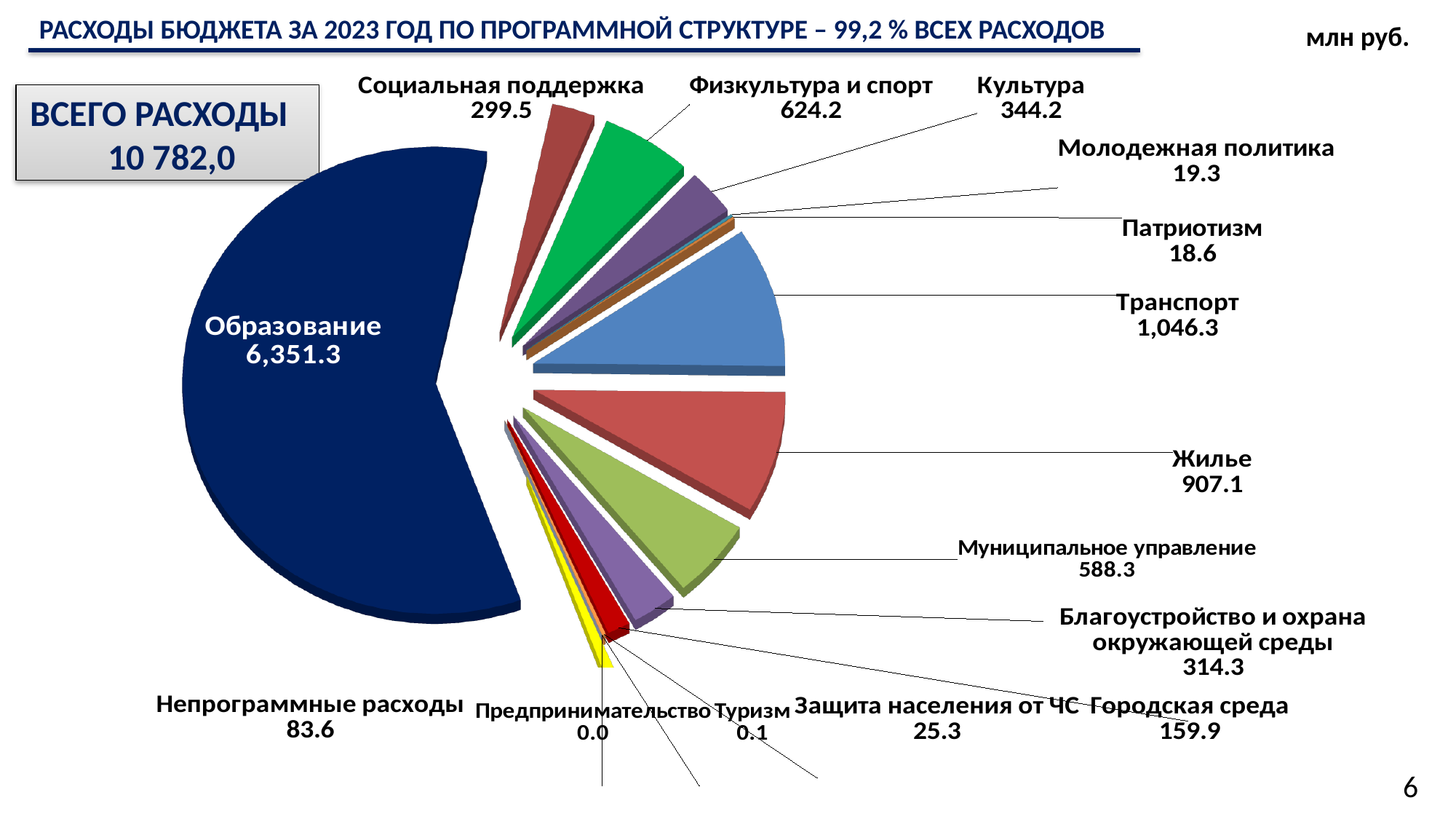
Which category has the largest slice in the pie chart? Образование What type of chart is shown on the slide? Pie chart What is the difference between the values for Физкультура и спорт and Культура? 280.0 What is the value for Образование in the pie chart? 6,351.3 What is the difference between the values for Транспорт and Жилье? 139.2 What is the value for Транспорт in the pie chart? 1,046.3 What is the value for Благоустройство и охрана окружающей среды? 314.3 Which is larger, Муниципальное управление or Социальная поддержка? Муниципальное управление What unit of measurement is indicated for the chart values? млн руб. What total expenditure is shown in the box on the slide (ВСЕГО РАСХОДЫ)? 10 782,0 How many categories are shown in the pie chart? 15 Which category has the smallest value in the pie chart? Предпринимательство